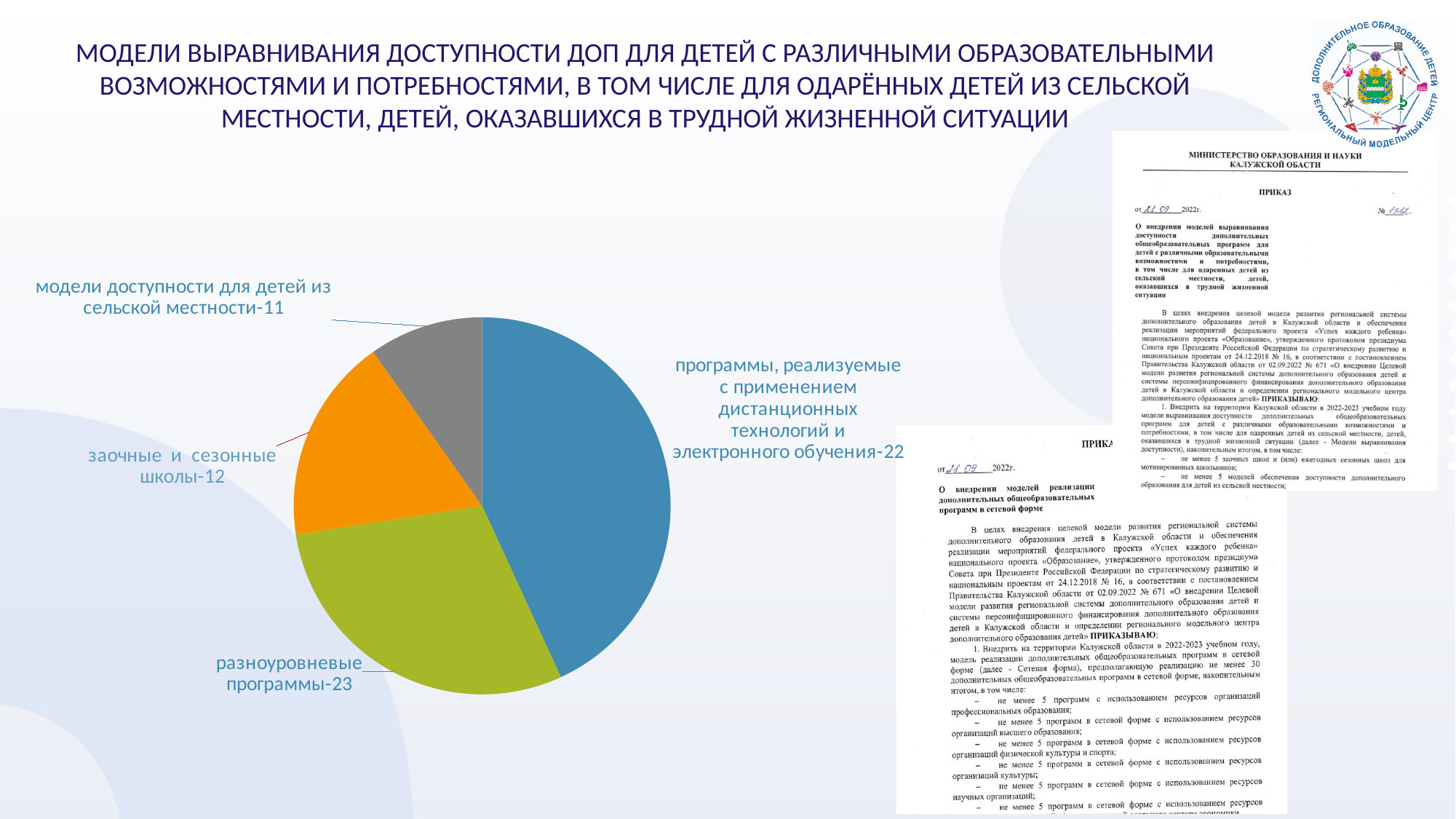
What type of chart is shown on the slide? Pie chart How many slices does the pie chart have? 4 What value is shown for «разноуровневые программы»? 23 What is the total of all four values shown in the pie chart? 68 Which is larger: «разноуровневые программы» or «заочные и сезонные школы»? разноуровневые программы What value is shown for «модели доступности для детей из сельской местности»? 11 What value is shown for «программы, реализуемые с применением дистанционных технологий и электронного обучения»? 22 What value is shown for «заочные и сезонные школы»? 12 What is the difference between the values for «программы, реализуемые с применением дистанционных технологий и электронного обучения» and «модели доступности для детей из сельской местности»? 11 Which is larger: «программы, реализуемые с применением дистанционных технологий и электронного обучения» or «модели доступности для детей из сельской местности»? программы, реализуемые с применением дистанционных технологий и электронного обучения What is the difference between the values for «разноуровневые программы» and «заочные и сезонные школы»? 11 What colour is the slice for «заочные и сезонные школы»? Orange